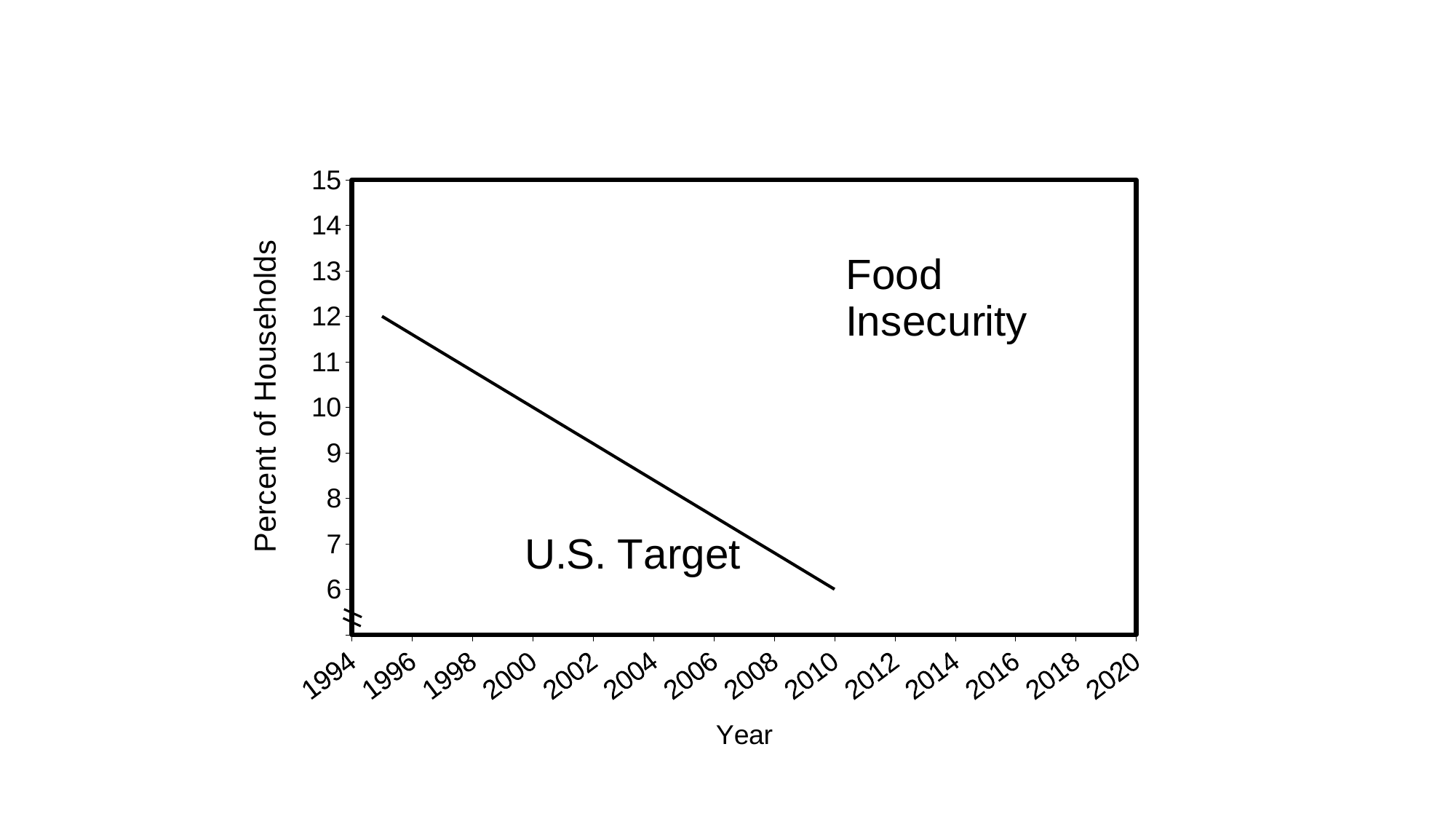
What is the label of the horizontal axis? Year What is the difference between the starting value (12) and the 2010 value (6) of the U.S. Target line? 6 What value does the U.S. Target line reach in 2010? 6 At what value does the U.S. Target line start at its left end? 12 Is the value of the U.S. Target line in 2002 greater or less than 10? less Is the value of the U.S. Target line in 2006 greater or less than 7? greater What is the label of the vertical axis? Percent of Households In which year does the U.S. Target line end? 2010 What kind of chart is shown on the slide? line chart Is the value of the U.S. Target line in 2000 greater or less than 9? greater Which is higher on the U.S. Target line: the value at its start or the value in 2010? the value at its start Does the U.S. Target line rise or fall as the year increases? fall